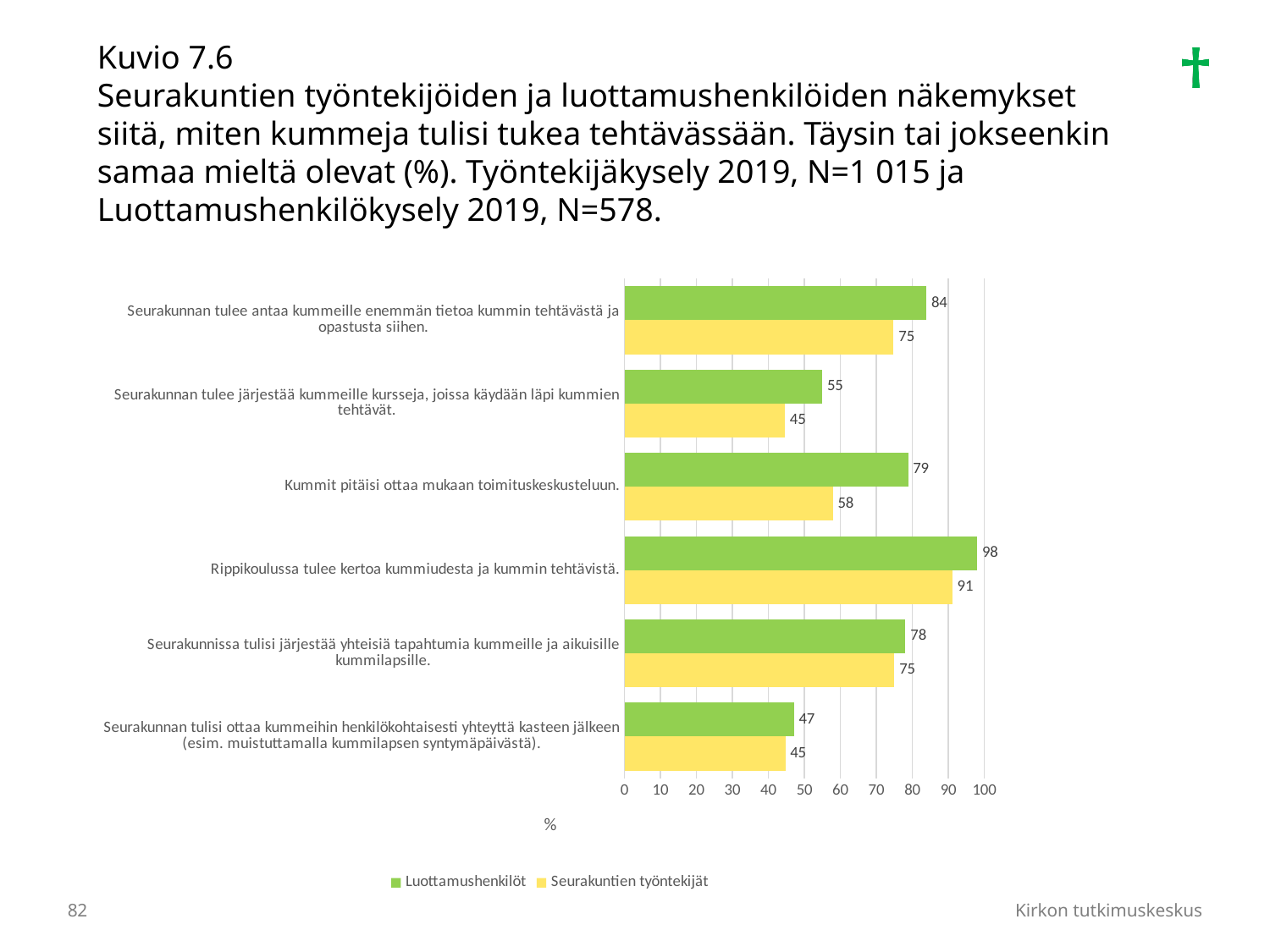
Which colour represents Seurakuntien työntekijät in the chart? Yellow What is the difference between the Luottamushenkilöt and Seurakuntien työntekijät values for "Kummit pitäisi ottaa mukaan toimituskeskusteluun."? 21 What is the difference between the Luottamushenkilöt and Seurakuntien työntekijät values for "Seurakunnan tulee antaa kummeille enemmän tietoa kummin tehtävästä ja opastusta siihen."? 9 What is the value for Seurakuntien työntekijät for "Kummit pitäisi ottaa mukaan toimituskeskusteluun."? 58 How many categories are shown on the chart? 6 What kind of chart is shown on the slide? Bar chart How many series does the legend list? 2 Which category has the lowest value for Luottamushenkilöt? Seurakunnan tulisi ottaa kummeihin henkilökohtaisesti yhteyttä kasteen jälkeen (esim. muistuttamalla kummilapsen syntymäpäivästä). What is the value for Seurakuntien työntekijät for "Seurakunnan tulee järjestää kummeille kursseja, joissa käydään läpi kummien tehtävät."? 45 What is the value for Luottamushenkilöt for "Rippikoulussa tulee kertoa kummiudesta ja kummin tehtävistä."? 98 Which category has the highest value for Luottamushenkilöt? Rippikoulussa tulee kertoa kummiudesta ja kummin tehtävistä. For "Seurakunnan tulee järjestää kummeille kursseja, joissa käydään läpi kummien tehtävät.", which series has the larger value, Luottamushenkilöt or Seurakuntien työntekijät? Luottamushenkilöt